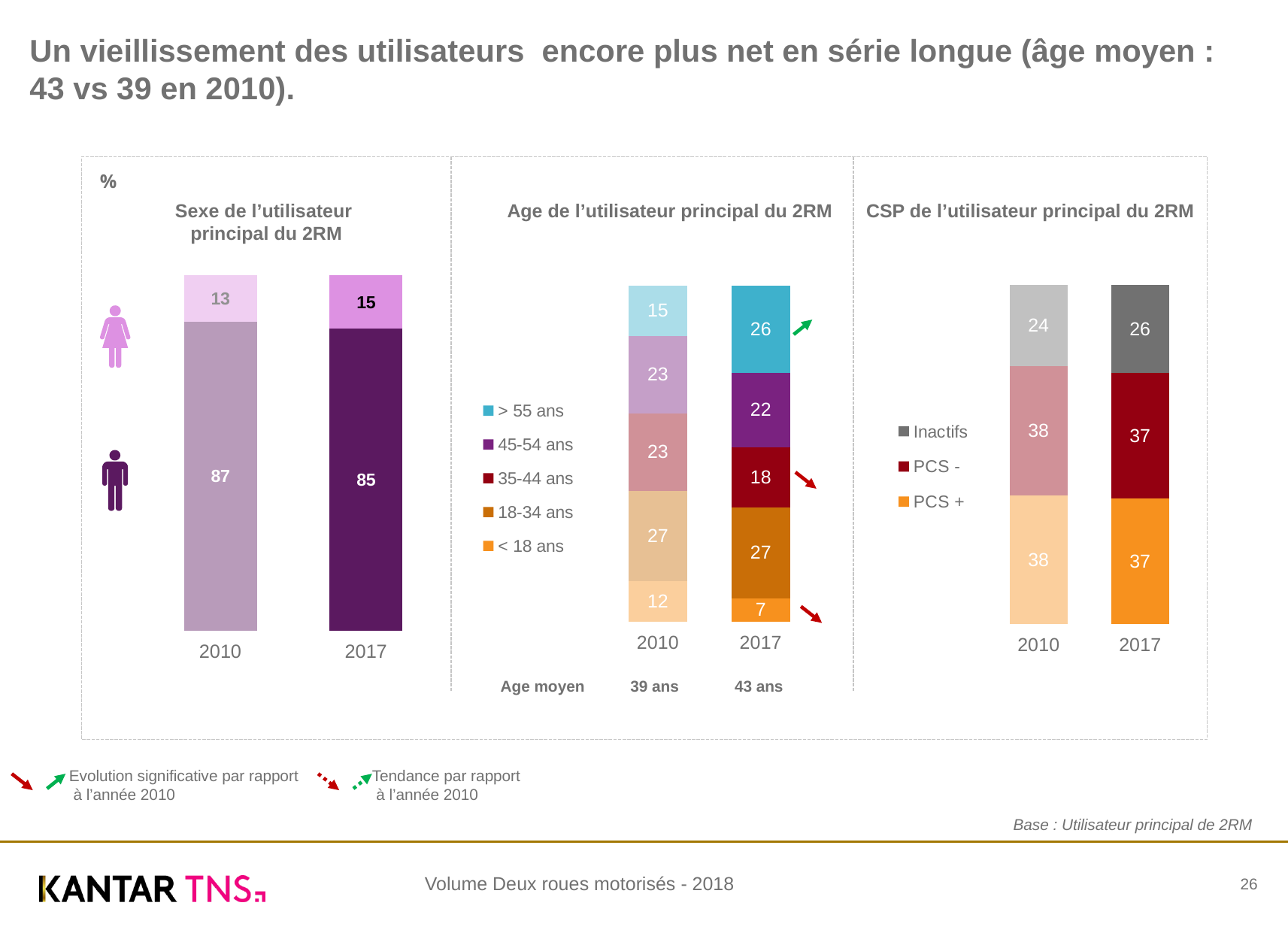
In the 'Age de l'utilisateur principal du 2RM' chart, which age group has the largest value in 2010? 18-34 ans In the 'Age de l'utilisateur principal du 2RM' chart, what is the difference between the '> 55 ans' values for 2017 and 2010? 11 In the 'Age de l'utilisateur principal du 2RM' chart, what is the average age shown for 2017? 43 ans In the 'Age de l'utilisateur principal du 2RM' chart, how many series does the legend list? 5 In the 'Age de l'utilisateur principal du 2RM' chart, what is the value for '< 18 ans' in 2010? 12 In the 'Age de l'utilisateur principal du 2RM' chart, what is the value for '> 55 ans' in 2017? 26 In the 'CSP de l'utilisateur principal du 2RM' chart, is the 'PCS +' value larger in 2010 or in 2017? 2010 In the 'Sexe de l'utilisateur principal du 2RM' chart, what is the value for the larger (male) segment in 2017? 85 What kind of chart is the 'Sexe de l'utilisateur principal du 2RM' chart? Stacked bar chart In the 'Age de l'utilisateur principal du 2RM' chart, which age group has the smallest value in 2017? < 18 ans In the 'CSP de l'utilisateur principal du 2RM' chart, what is the value for 'Inactifs' in 2010? 24 In the 'CSP de l'utilisateur principal du 2RM' chart, how many series does the legend list? 3